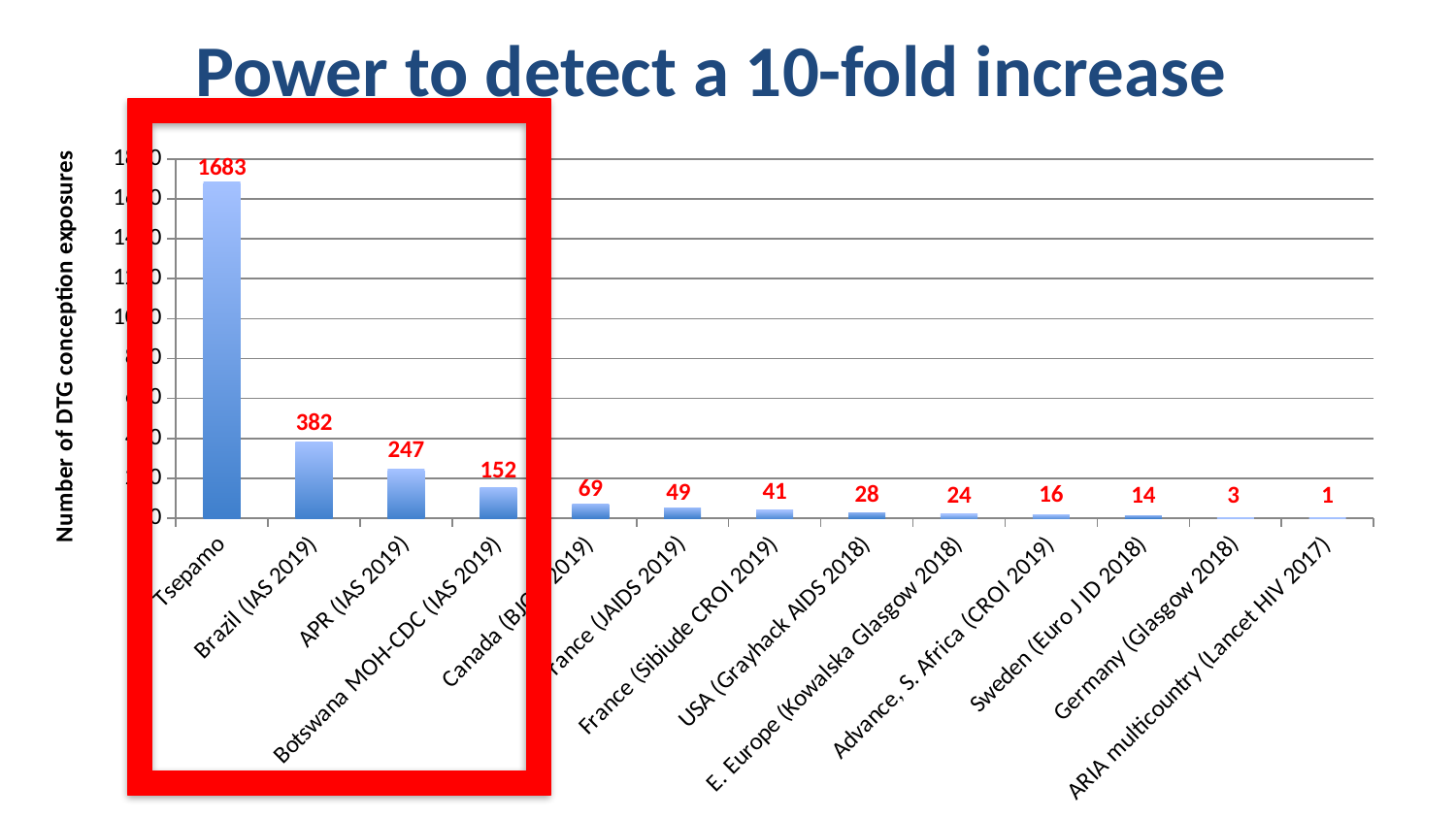
Which is larger, the value for France (JAIDS 2019) or the value for France (Sibiude CROI 2019)? France (JAIDS 2019) Which category has the highest value? Tsepamo What is the value for Brazil (IAS 2019)? 382 Which category has the lowest value? ARIA multicountry (Lancet HIV 2017) What type of chart is shown on the slide? bar chart What is the difference between the values for Brazil (IAS 2019) and APR (IAS 2019)? 135 What is the value for Botswana MOH-CDC (IAS 2019)? 152 Do the values rise or fall from left to right along the x axis? fall What is the value for Tsepamo? 1683 How many categories are plotted in the chart? 13 What is the value for USA (Grayhack AIDS 2018)? 28 What is the label of the vertical axis? Number of DTG conception exposures